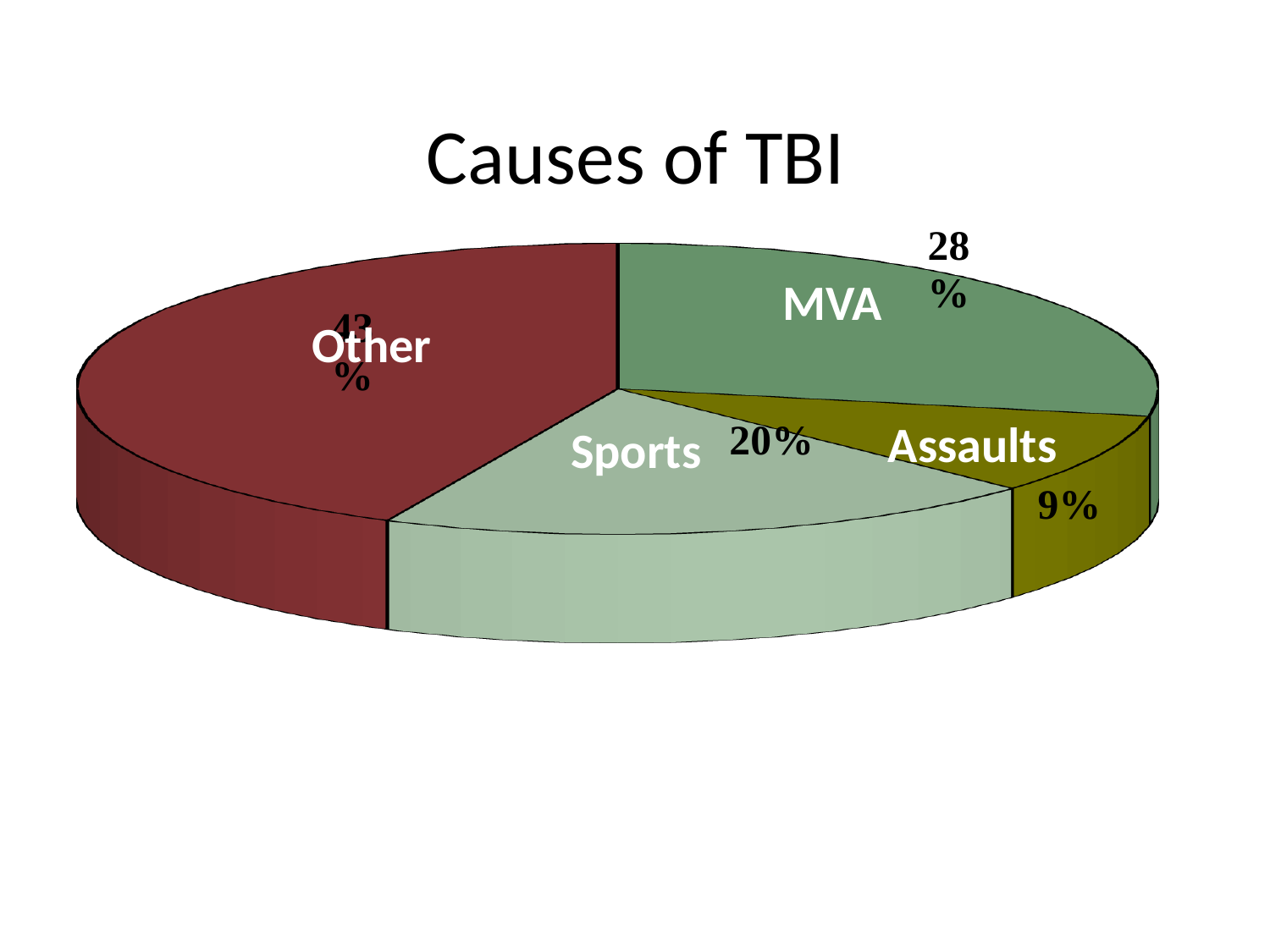
Which is larger, the MVA slice or the Assaults slice? MVA What colour is the Other slice? dark red What is the difference in percentage points between MVA and Sports? 8 What percentage of TBI causes is attributed to Sports? 20% Which cause has the smallest slice of the pie? Assaults What percentage of TBI causes is attributed to MVA? 28% What is the difference in percentage points between Sports and Assaults? 11 Which cause has the largest slice of the pie? Other What type of chart is shown on the slide? pie chart What is the title of the chart? Causes of TBI What percentage of TBI causes is attributed to Assaults? 9% How many slices does the pie chart have? 4